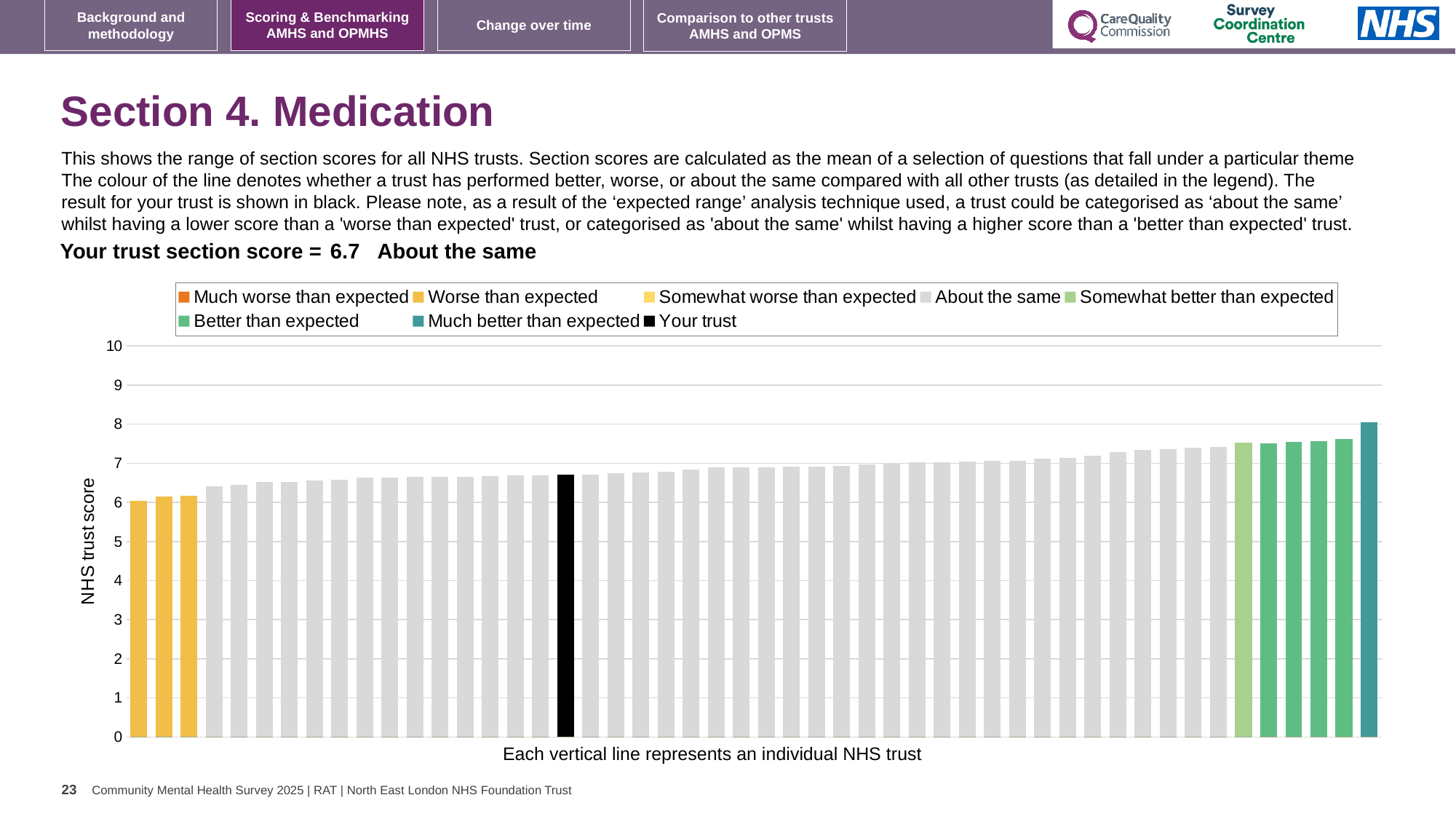
How many bars are coloured as 'Worse than expected'? 3 What is the section score for your trust shown on the slide? 6.7 How many entries does the chart legend list? 8 Do the bar values rise or fall from left to right along the x axis? rise Is the value for your trust greater or less than 5? greater Is the bar for your trust taller or shorter than the rightmost bar? shorter How many bars are coloured as 'Better than expected'? 4 Is the value of the leftmost bar greater or less than 7? less Is the value of the tallest bar (Much better than expected) greater or less than 7? greater What is the label on the vertical axis of the chart? NHS trust score Which benchmarking category is your trust placed in for the Medication section? About the same What kind of chart is shown on the slide? bar chart